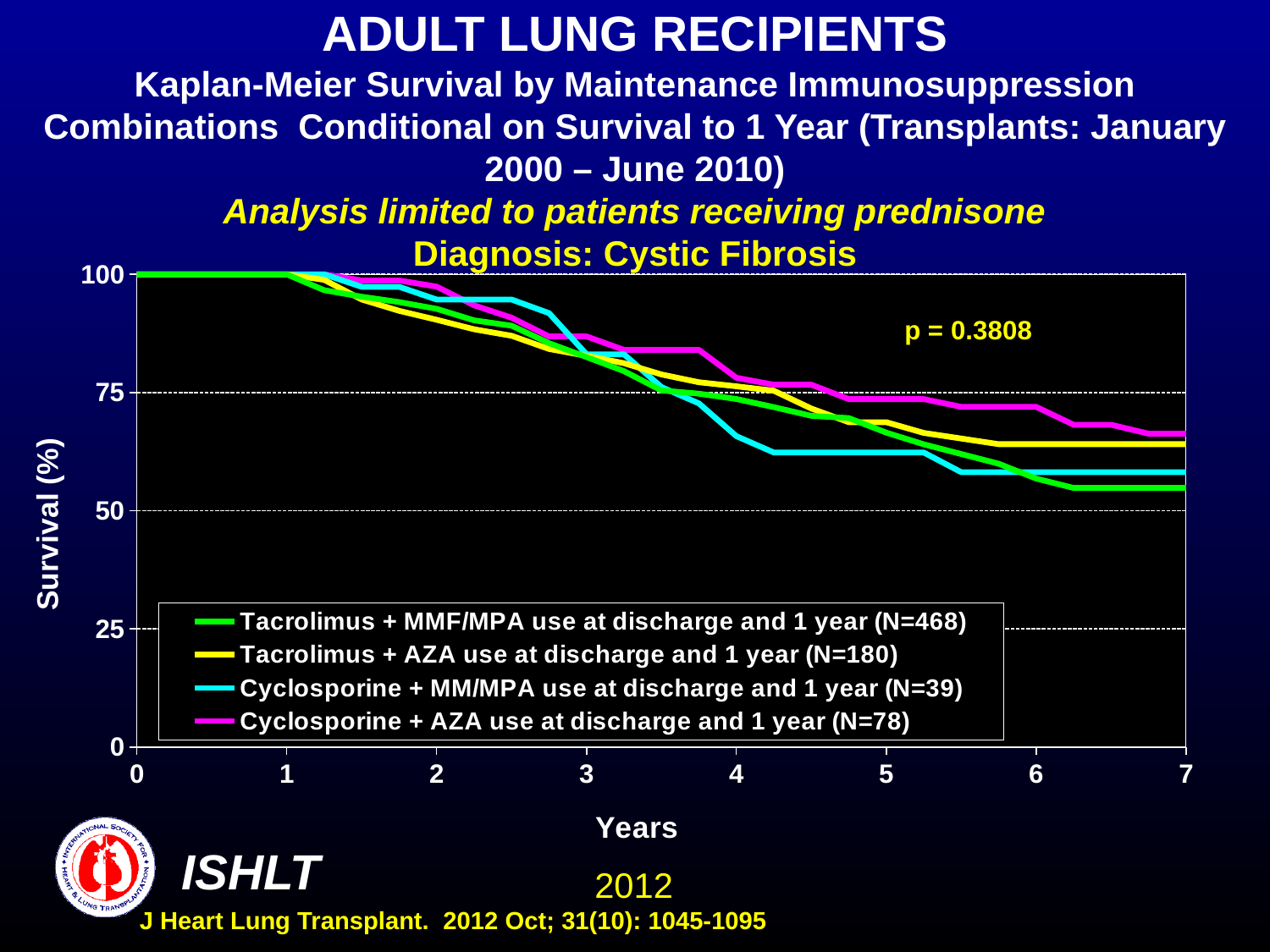
At year 7, which series has the lowest survival? Tacrolimus + MMF/MPA use at discharge and 1 year How many series does the legend list? 4 What is the p-value shown on the chart? p = 0.3808 What kind of chart is shown on the slide? line chart At year 7, which series has higher survival: Cyclosporine + AZA use at discharge and 1 year or Tacrolimus + MMF/MPA use at discharge and 1 year? Cyclosporine + AZA use at discharge and 1 year Is the survival value for Tacrolimus + MMF/MPA use at discharge and 1 year at year 7 greater or less than 75? less What is the N for the Tacrolimus + MMF/MPA use at discharge and 1 year series in the legend? N=468 Is the survival value for Tacrolimus + AZA use at discharge and 1 year at year 7 greater or less than 50? greater What is the maximum value shown on the Survival (%) axis? 100 Is the survival value for Cyclosporine + MM/MPA use at discharge and 1 year at year 4 greater or less than 75? less Do the survival curves rise or fall as years increase along the x axis? fall